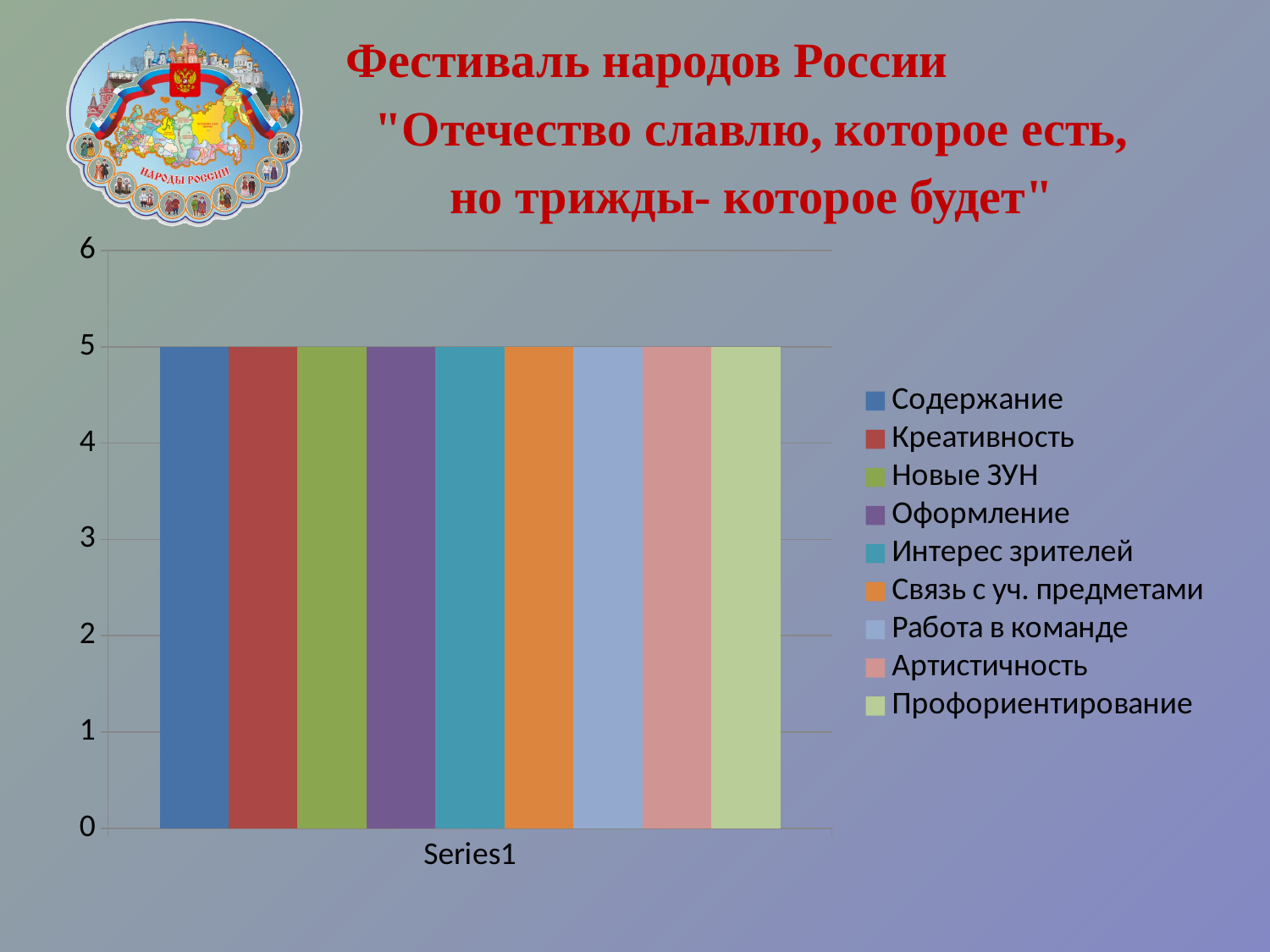
What is the value for Работа в команде? 5 What is the label of the category on the x axis? Series1 Is the value for Оформление greater or less than 4? greater What is the difference between the values for Артистичность and Новые ЗУН? 0 How many series does the legend list? 9 Which legend entry is shown in orange? Связь с уч. предметами What is the value for Содержание? 5 What is the value for Креативность? 5 Is the value for Интерес зрителей greater or less than 6? less What is the value for Профориентирование? 5 How many categories are shown on the x axis? 1 What kind of chart is shown on the slide? bar chart